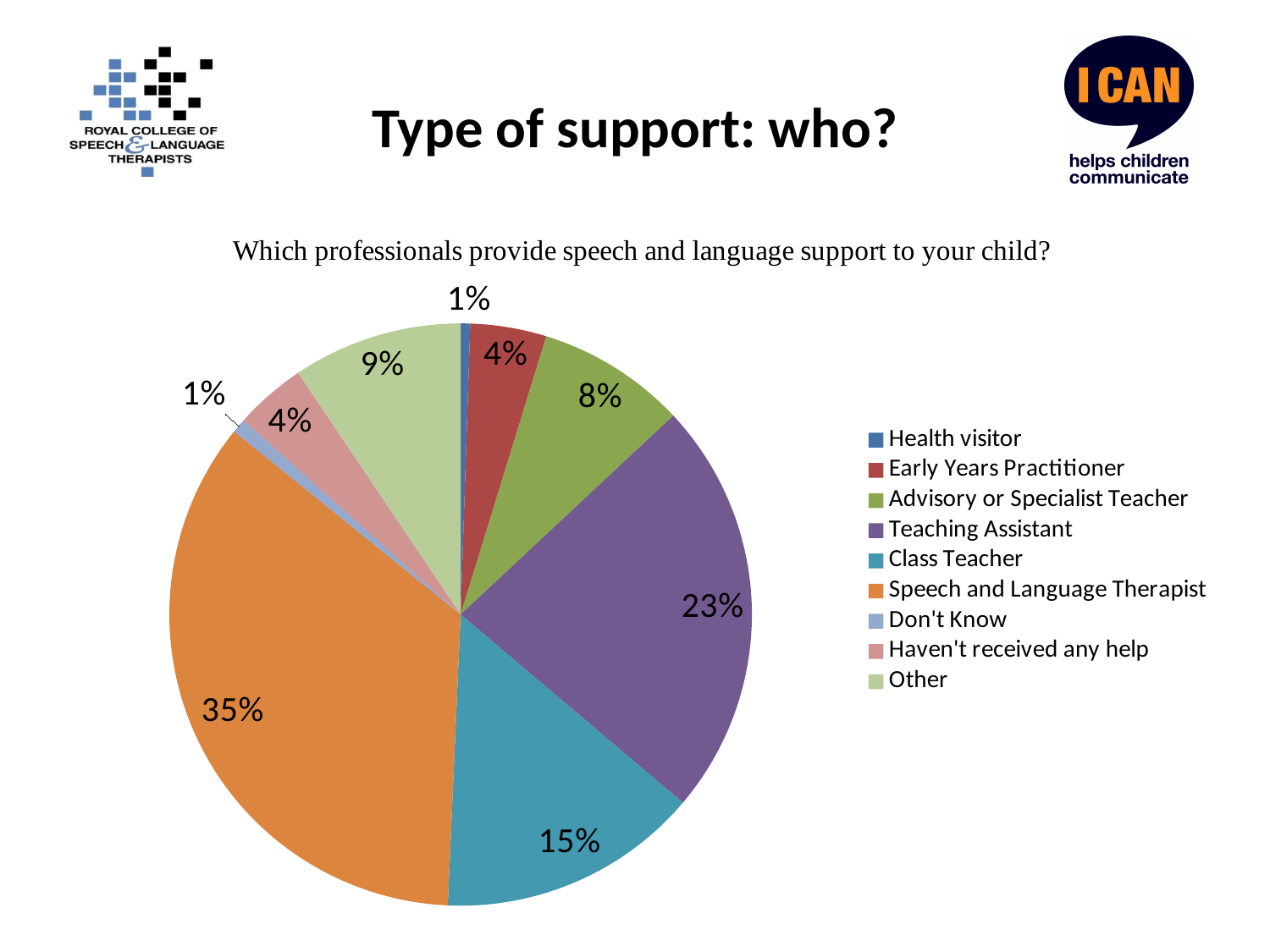
Which is larger, the Class Teacher share or the Other share? Class Teacher What question is shown as the chart's title? Which professionals provide speech and language support to your child? What is the difference between the Speech and Language Therapist share and the Teaching Assistant share? 12% How many categories does the legend list? 9 What share of the pie is Class Teacher? 15% What kind of chart is shown on the slide? pie chart What share of the pie is Teaching Assistant? 23% What is the difference between the Teaching Assistant share and the Class Teacher share? 8% Which category has the largest slice of the pie? Speech and Language Therapist What share of the pie is Other? 9%